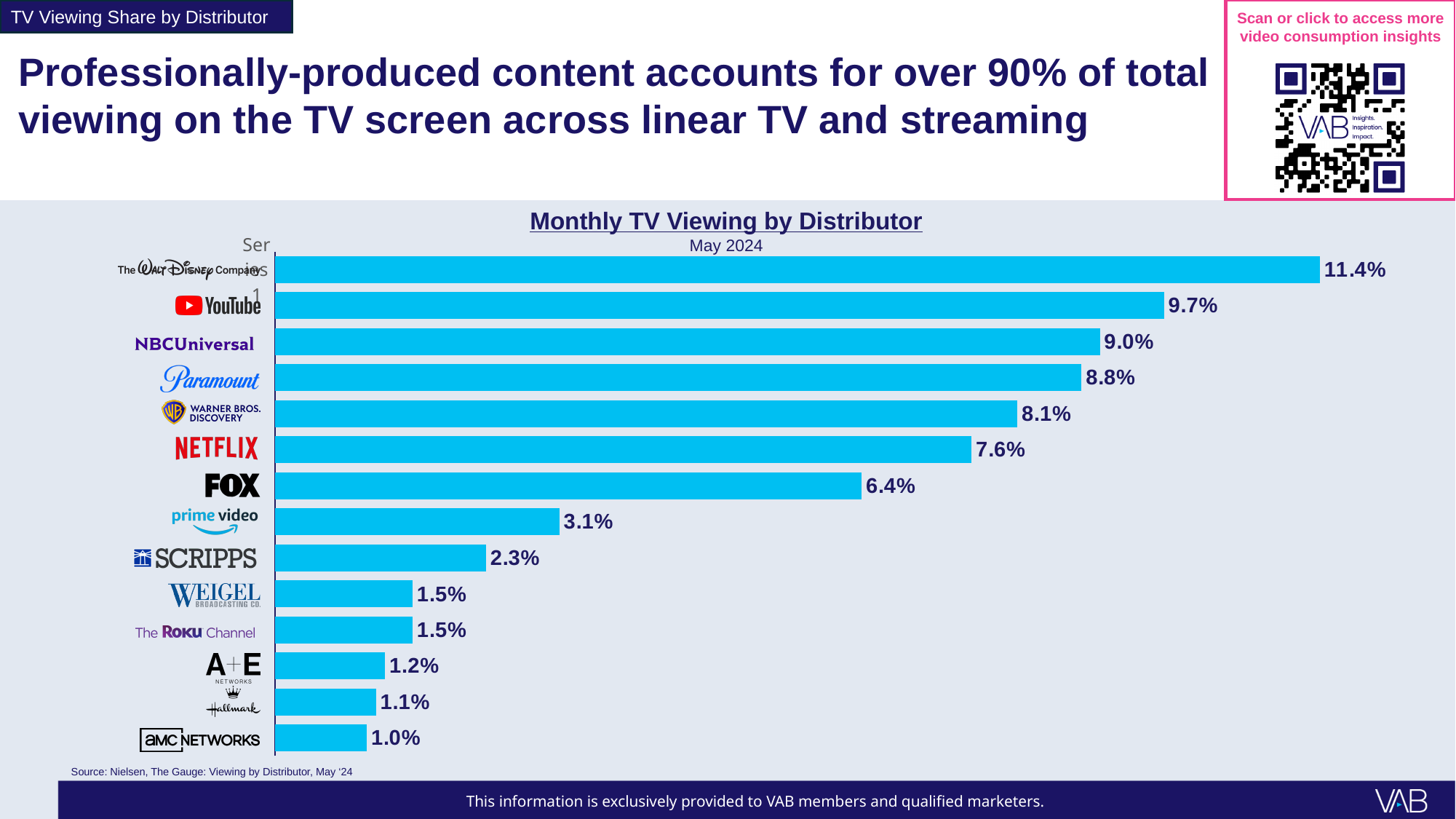
What is the monthly TV viewing share for Prime Video? 3.1% What is the difference in viewing share between The Walt Disney Company and Fox? 5.0% How many distributors are shown in the chart? 14 What is the difference in viewing share between YouTube and NBCUniversal? 0.7% Which has a larger viewing share, Scripps or Prime Video? Prime Video Which distributor has the lowest monthly TV viewing share? AMC Networks What is the monthly TV viewing share for The Walt Disney Company? 11.4% What kind of chart is used to show monthly TV viewing by distributor? Bar chart What is the monthly TV viewing share for Netflix? 7.6% Which distributor has the highest monthly TV viewing share? The Walt Disney Company Which has a larger viewing share, Paramount or Warner Bros. Discovery? Paramount What month and year does the chart cover? May 2024